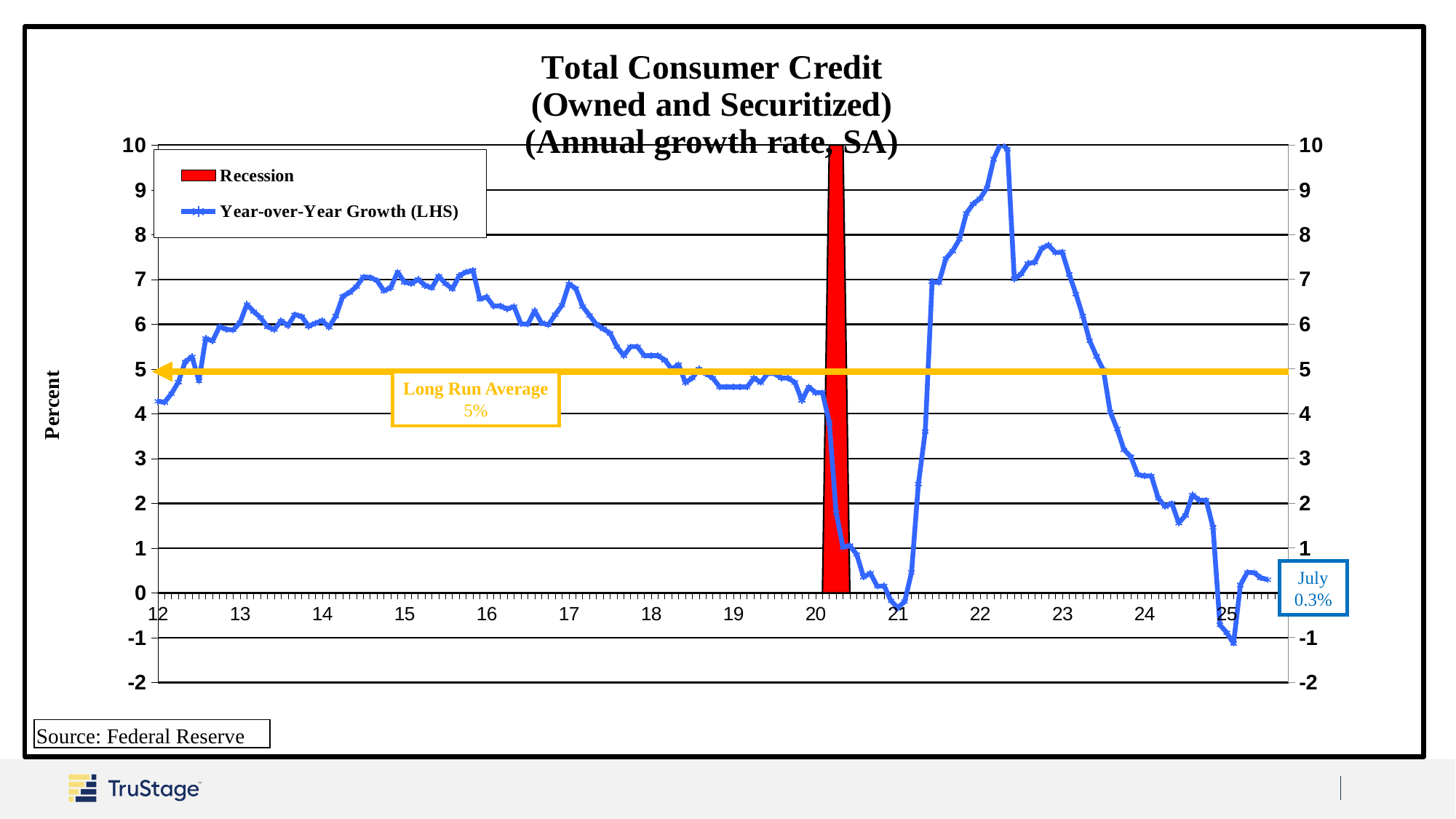
Which is larger, the year-over-year growth value at the 15 tick or at the 19 tick? 15 Does the year-over-year growth line rise or fall between the 23 tick and the 25 tick? fall What is the label on the vertical axis? Percent What source is cited for the chart? Federal Reserve Is the highest point of the year-over-year growth line above or below 9? above What kind of chart is shown on the slide? line chart How many entries does the legend list? 2 Is the year-over-year growth value at the 21 tick greater or less than 1? less What is the year-over-year growth value labelled for July? 0.3% Is the year-over-year growth value at the 22 tick greater or less than 5? greater What is the Long Run Average shown on the chart? 5%